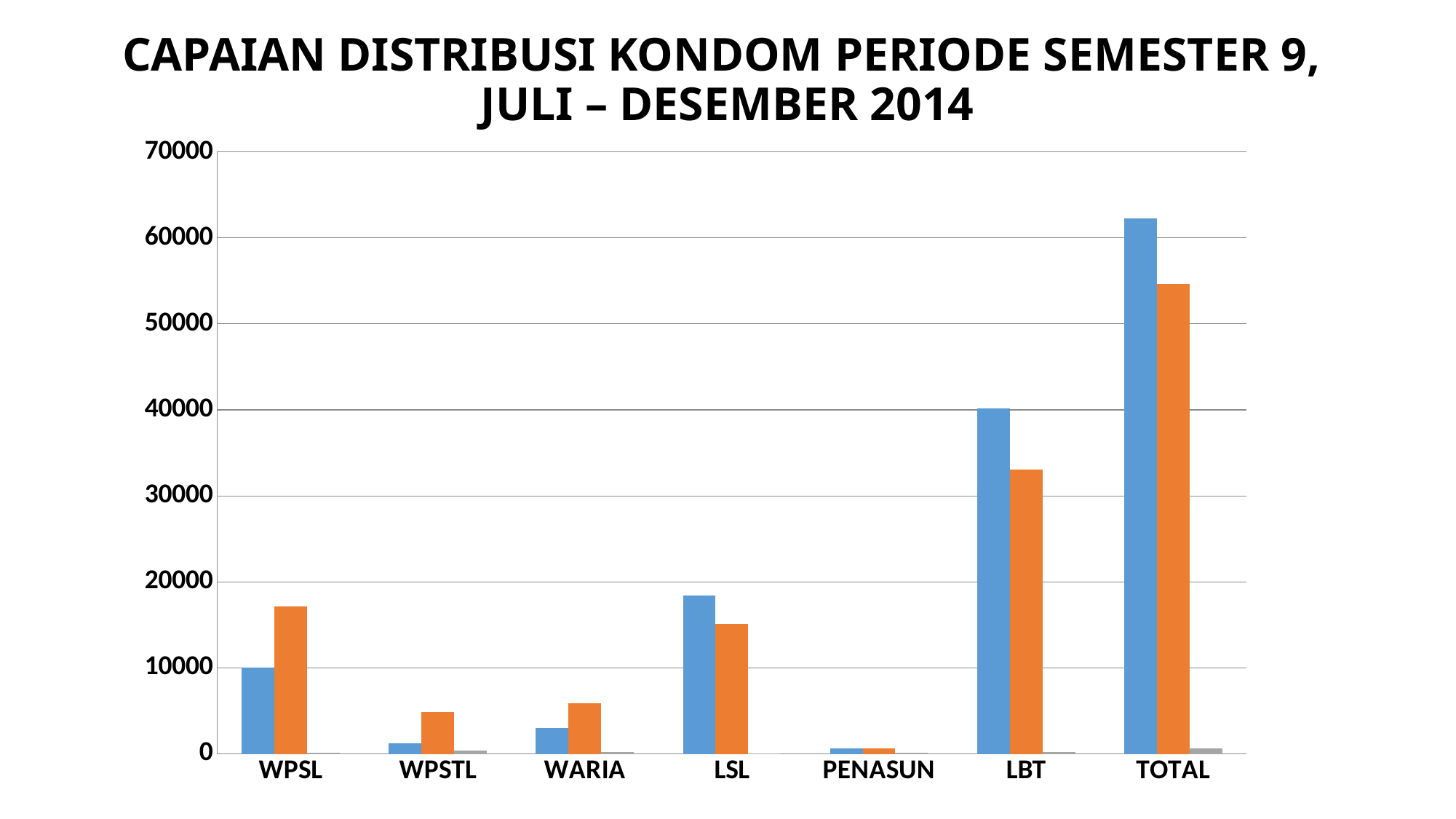
Which category has the tallest blue bar? TOTAL What is the title of the chart? CAPAIAN DISTRIBUSI KONDOM PERIODE SEMESTER 9, JULI – DESEMBER 2014 For WPSL, which bar is taller, the blue one or the orange one? orange What kind of chart is shown on the slide? bar chart Is the orange bar for TOTAL greater or less than 60000? less Is the orange bar for LBT greater or less than 30000? greater Which category has the shortest blue bar? PENASUN Is the orange bar for WARIA greater or less than 10000? less How many categories are shown on the x axis? 7 For LSL, which bar is taller, the blue one or the orange one? blue